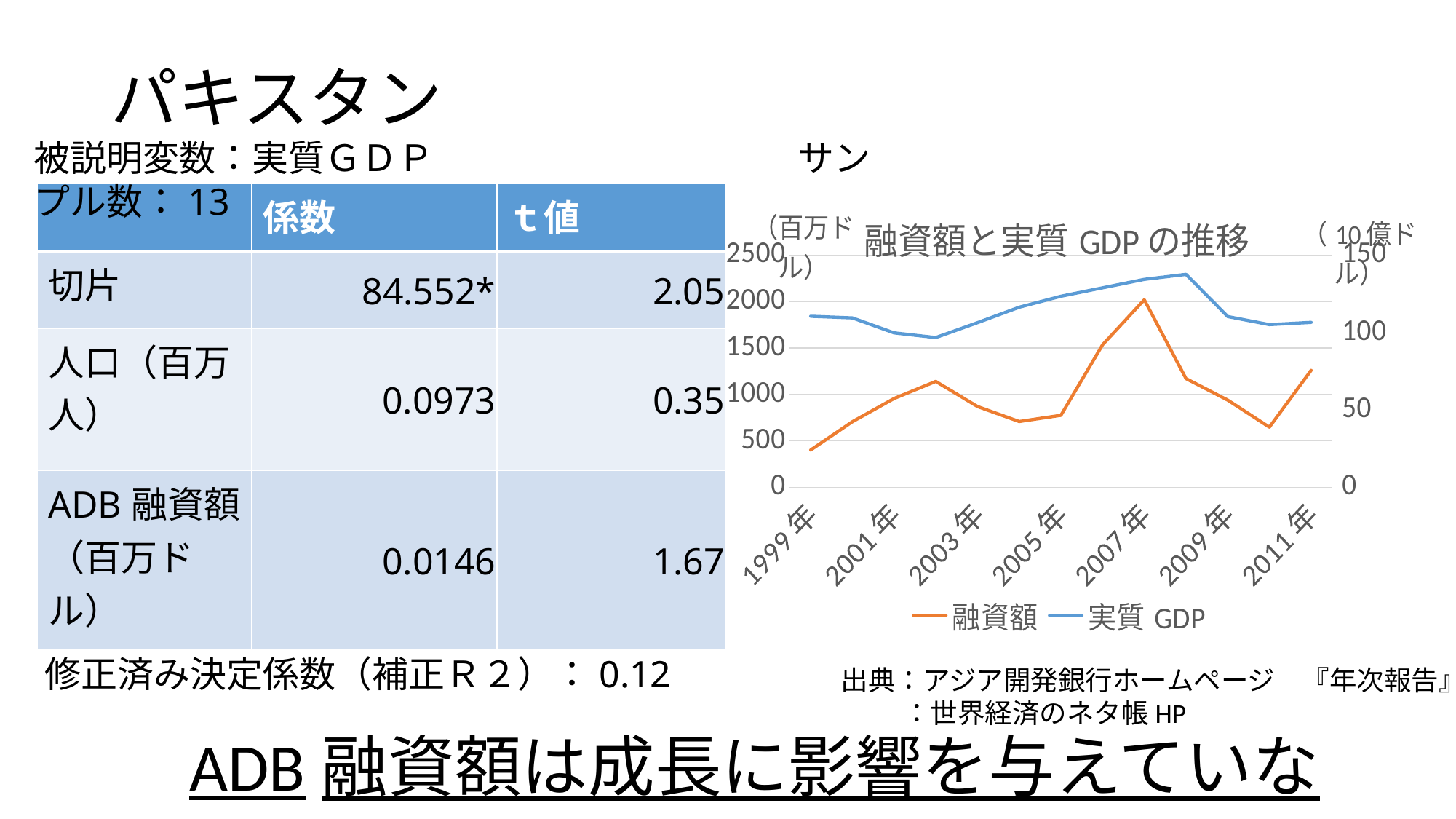
Which series is drawn in orange in the chart? 融資額 In which year does the 融資額 series reach its highest point? 2007年 Does the 実質GDP series rise or fall between 2003年 and 2009年? rise In which year is the 融資額 series at its lowest point? 1999年 How many year labels are shown on the x axis of the chart? 7 Is the 融資額 value for 1999年 greater or less than 500 on the left axis? less Which is larger, the 融資額 value for 2007年 or for 2011年? 2007年 What is the title of the chart? 融資額と実質GDPの推移 What kind of chart is shown on the slide? line chart How many series does the chart legend list? 2 Is the 融資額 value for 2007年 greater or less than 1500 on the left axis? greater